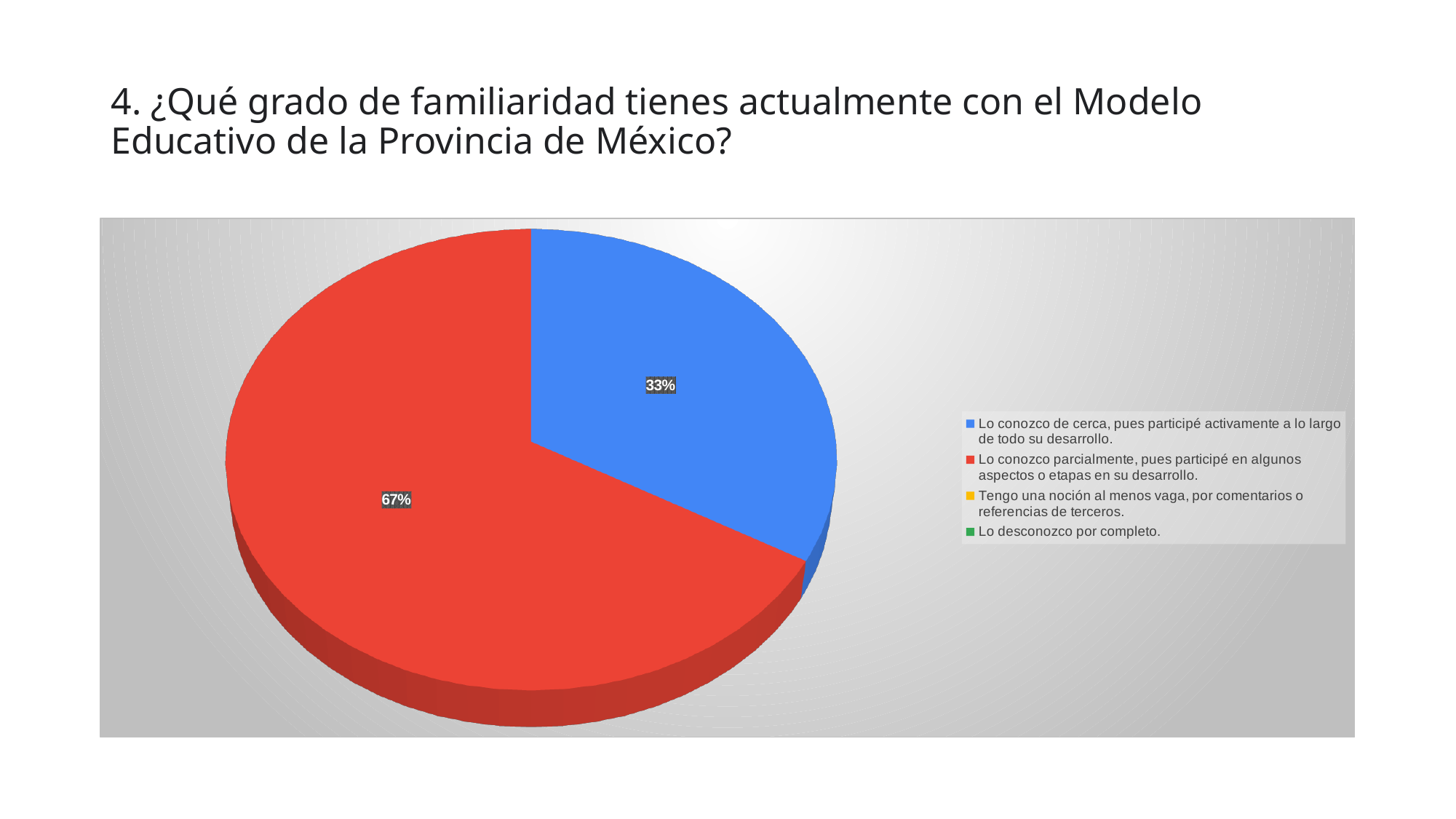
What colour is the slice for "Lo conozco de cerca, pues participé activamente a lo largo de todo su desarrollo."? blue What colour does the legend assign to "Lo desconozco por completo."? green How many slices are visible in the pie? 2 What is the total of the two labelled slices in the pie? 100% What is the difference in percentage points between the "Lo conozco parcialmente" slice and the "Lo conozco de cerca" slice? 34 percentage points What share of the pie does "Lo conozco de cerca, pues participé activamente a lo largo de todo su desarrollo." represent? 33% Which category has the largest slice of the pie? Lo conozco parcialmente, pues participé en algunos aspectos o etapas en su desarrollo. What share of the pie does "Lo conozco parcialmente, pues participé en algunos aspectos o etapas en su desarrollo." represent? 67% Which is larger: the slice for "Lo conozco de cerca" or the slice for "Lo conozco parcialmente"? Lo conozco parcialmente What kind of chart is shown on the slide? pie chart How many categories does the legend list? 4